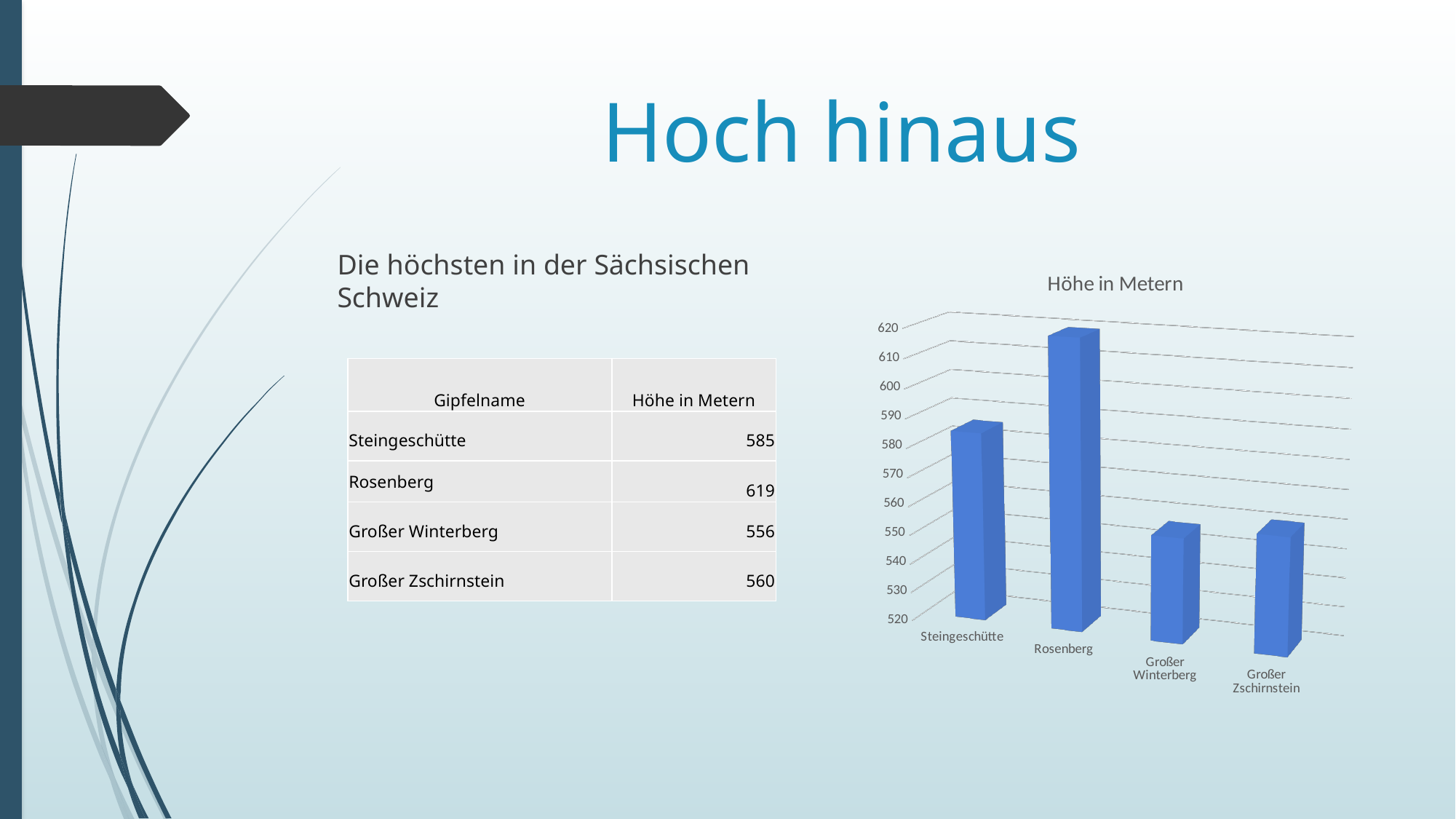
How many peaks are plotted in the chart? 4 What is the difference in height between Rosenberg and Steingeschütte? 34 What is the height in metres for Steingeschütte? 585 What is the height in metres for Großer Zschirnstein? 560 Is the value for Steingeschütte greater or less than 600? less Is the value for Rosenberg greater or less than 610? greater Which peak has the highest value in the chart? Rosenberg What kind of chart is shown on the slide? bar chart What is the height in metres for Rosenberg? 619 What is the title of the chart? Höhe in Metern Which peak has the lowest value in the chart? Großer Winterberg Which is higher, Großer Zschirnstein or Großer Winterberg? Großer Zschirnstein